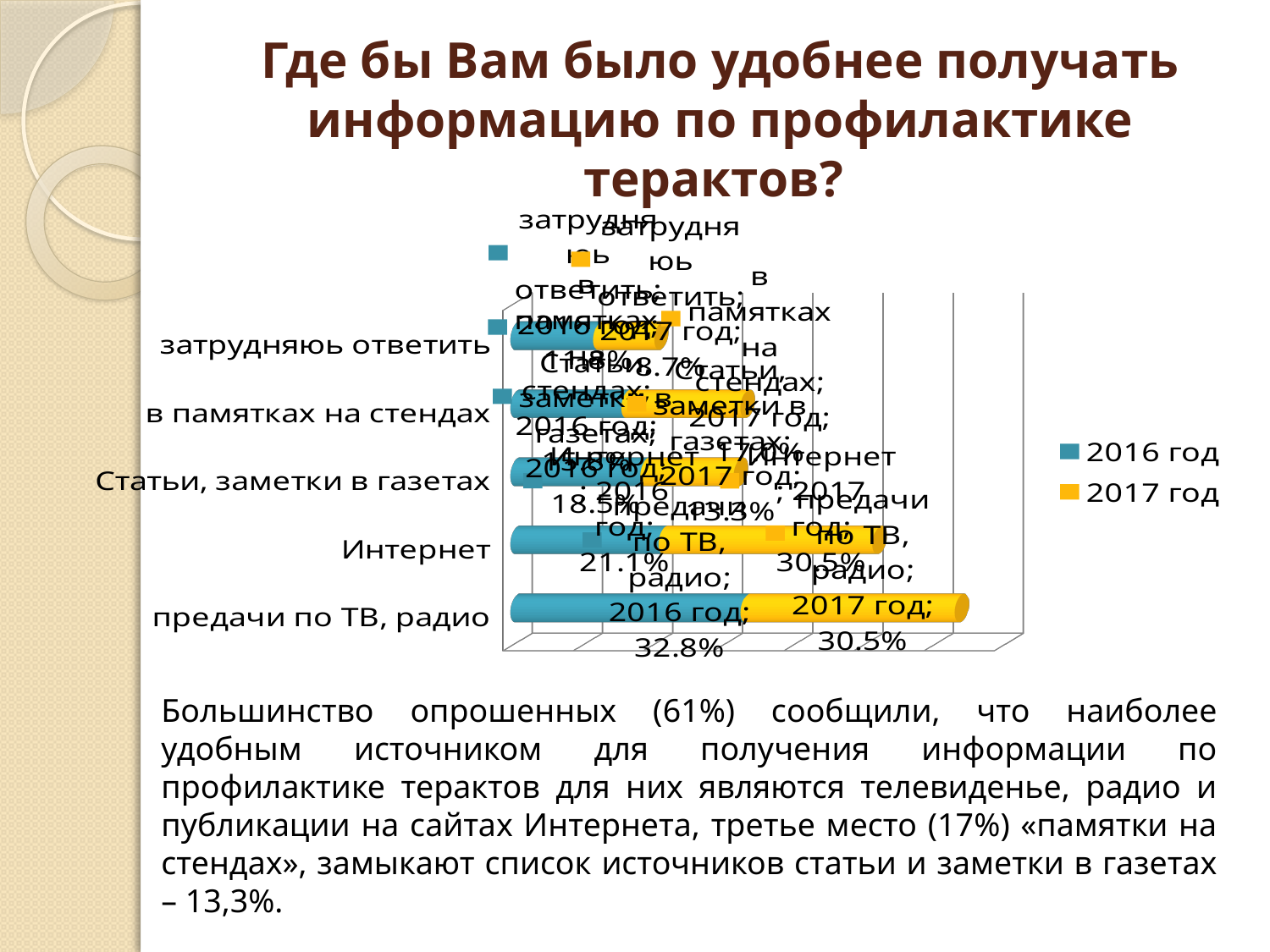
For 'предачи по ТВ, радио', which year has the larger value, 2016 год or 2017 год? 2016 год Which category has the highest value for 2016 год? предачи по ТВ, радио Which colour represents the 2017 год series? yellow Which category has the lowest value for 2016 год? затрудняюь ответить How many series does the legend list? 2 Which series are listed in the legend? 2016 год, 2017 год What is the value for 'Интернет' in 2016 год? 21.1% What is the difference between the 2016 год and 2017 год values for 'предачи по ТВ, радио'? 2.3% What is the value for 'предачи по ТВ, радио' in 2016 год? 32.8% What is the value for 'предачи по ТВ, радио' in 2017 год? 30.5% How many categories are shown on the chart? 5 What kind of chart is shown on the slide? bar chart